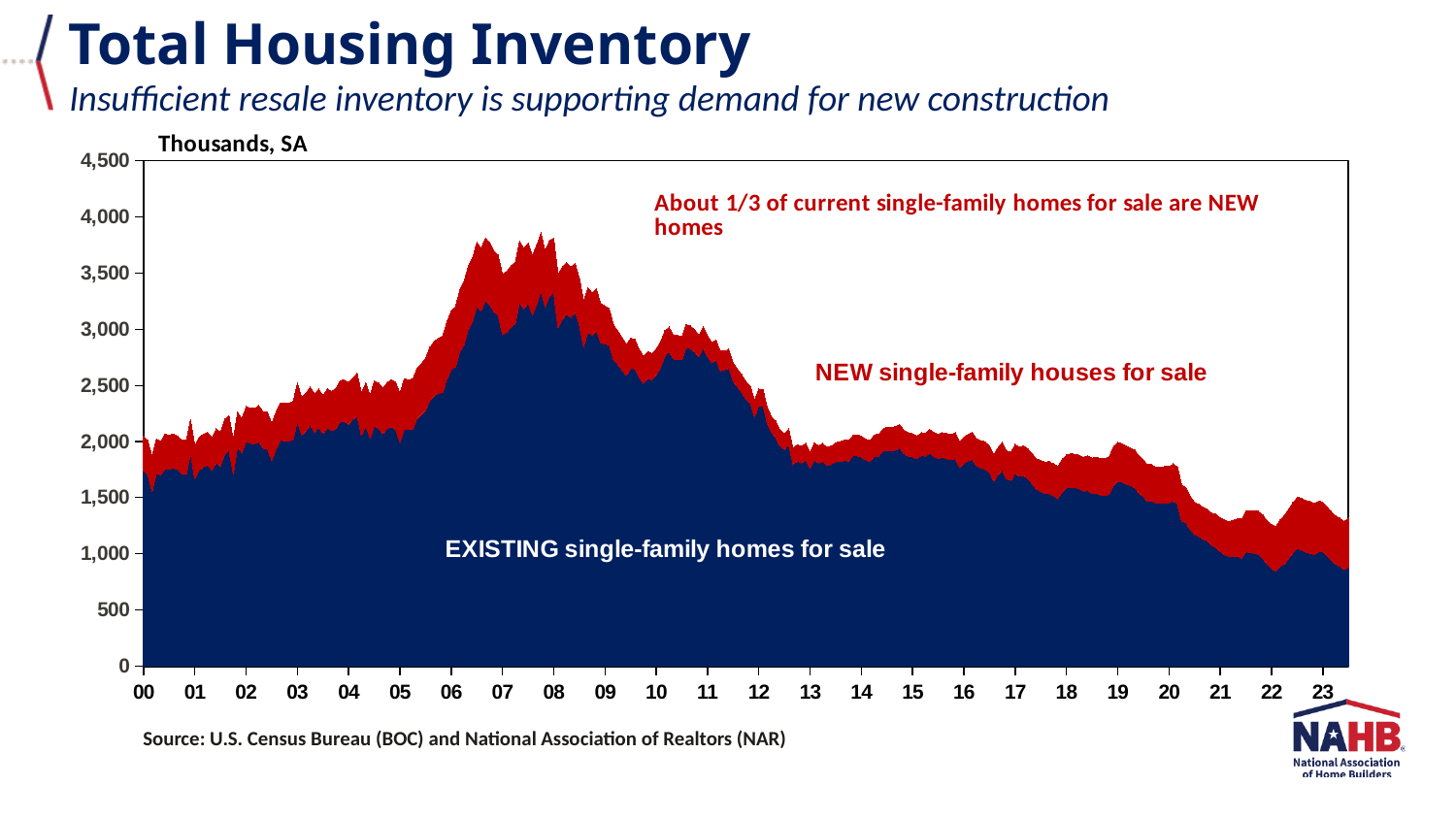
Does the total housing inventory rise or fall from 2008 to 2023? Fall What unit is stated above the y axis of the chart? Thousands, SA Is the total housing inventory at the end of 2023 greater or less than 1,500 thousand? less According to the annotation on the chart, what fraction of current single-family homes for sale are new homes? About 1/3 Is the total housing inventory at its 2007 peak greater or less than 3,500 thousand? greater What kind of chart is shown on the slide? Stacked area chart How many year labels appear along the x axis of the chart? 24 Is the total housing inventory larger in 2007 or in 2023? 2007 How many data series are plotted in the chart? 2 Which series is larger throughout the chart, EXISTING single-family homes for sale or NEW single-family houses for sale? EXISTING single-family homes for sale Is the inventory of EXISTING single-family homes for sale at the end of 2023 greater or less than 1,000 thousand? less